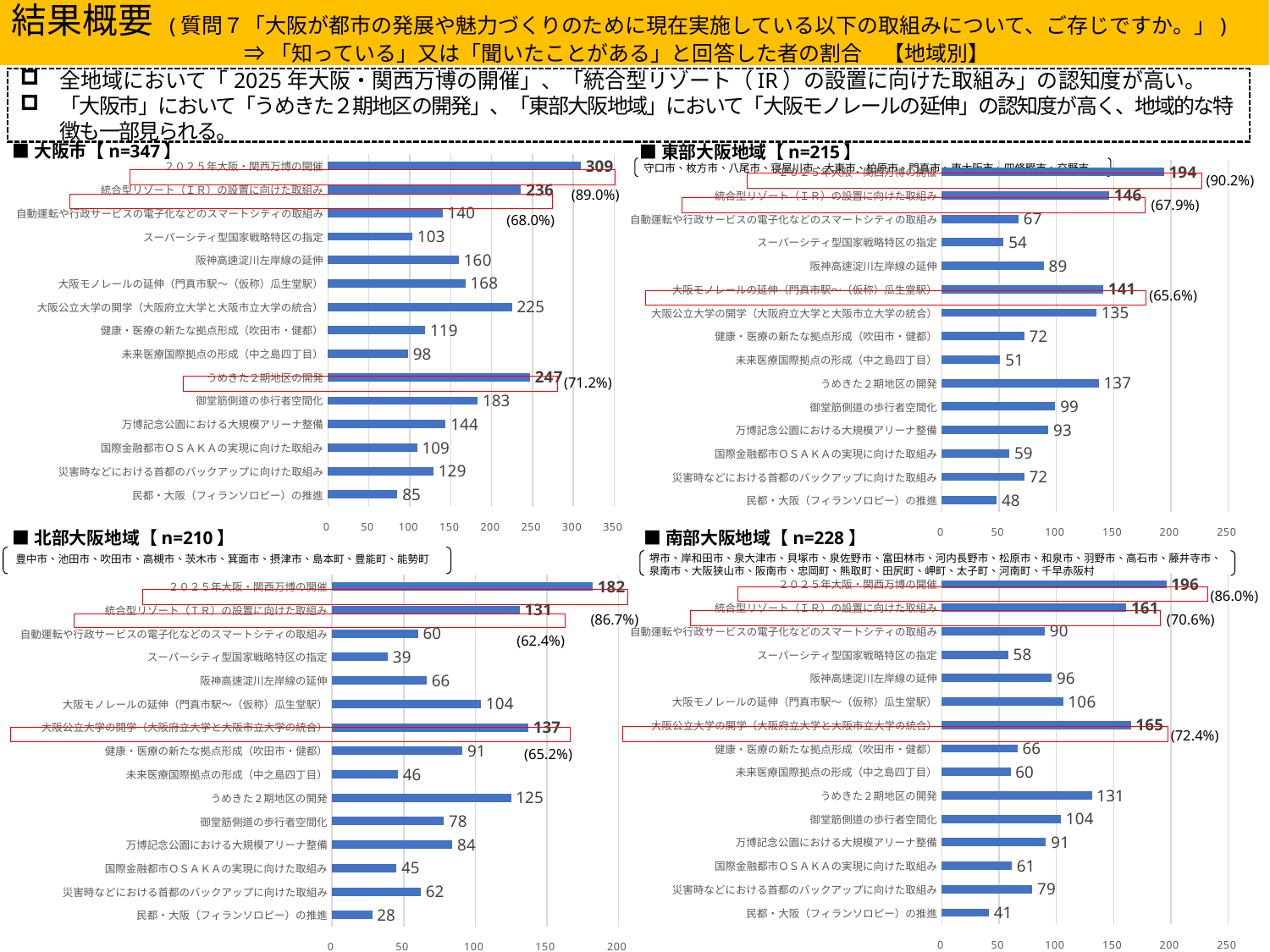
How many categories are plotted in the 大阪市【n=347】 chart? 15 In the 大阪市【n=347】 chart, what is the value for うめきた２期地区の開発? 247 In the 北部大阪地域【n=210】 chart, which category has the lowest value? 民都・大阪（フィランソロピー）の推進 In the 北部大阪地域【n=210】 chart, what is the value for 大阪公立大学の開学（大阪府立大学と大阪市立大学の統合）? 137 What kind of chart is the 北部大阪地域【n=210】 chart? Bar chart In the 大阪市【n=347】 chart, which is larger: 阪神高速淀川左岸線の延伸 or 大阪モノレールの延伸（門真市駅～（仮称）瓜生堂駅）? 大阪モノレールの延伸（門真市駅～（仮称）瓜生堂駅） In the 大阪市【n=347】 chart, what percentage is shown next to the bar for うめきた２期地区の開発? 71.2% In the 東部大阪地域【n=215】 chart, what is the value for 大阪モノレールの延伸（門真市駅～（仮称）瓜生堂駅）? 141 In the 南部大阪地域【n=228】 chart, what is the difference between ２０２５年大阪・関西万博の開催 and 統合型リゾート（ＩＲ）の設置に向けた取組み? 35 In the 東部大阪地域【n=215】 chart, what is the difference between ２０２５年大阪・関西万博の開催 and 統合型リゾート（ＩＲ）の設置に向けた取組み? 48 In the 東部大阪地域【n=215】 chart, which category has the highest value? ２０２５年大阪・関西万博の開催 In the 南部大阪地域【n=228】 chart, what is the value for the lowest category, 民都・大阪（フィランソロピー）の推進? 41